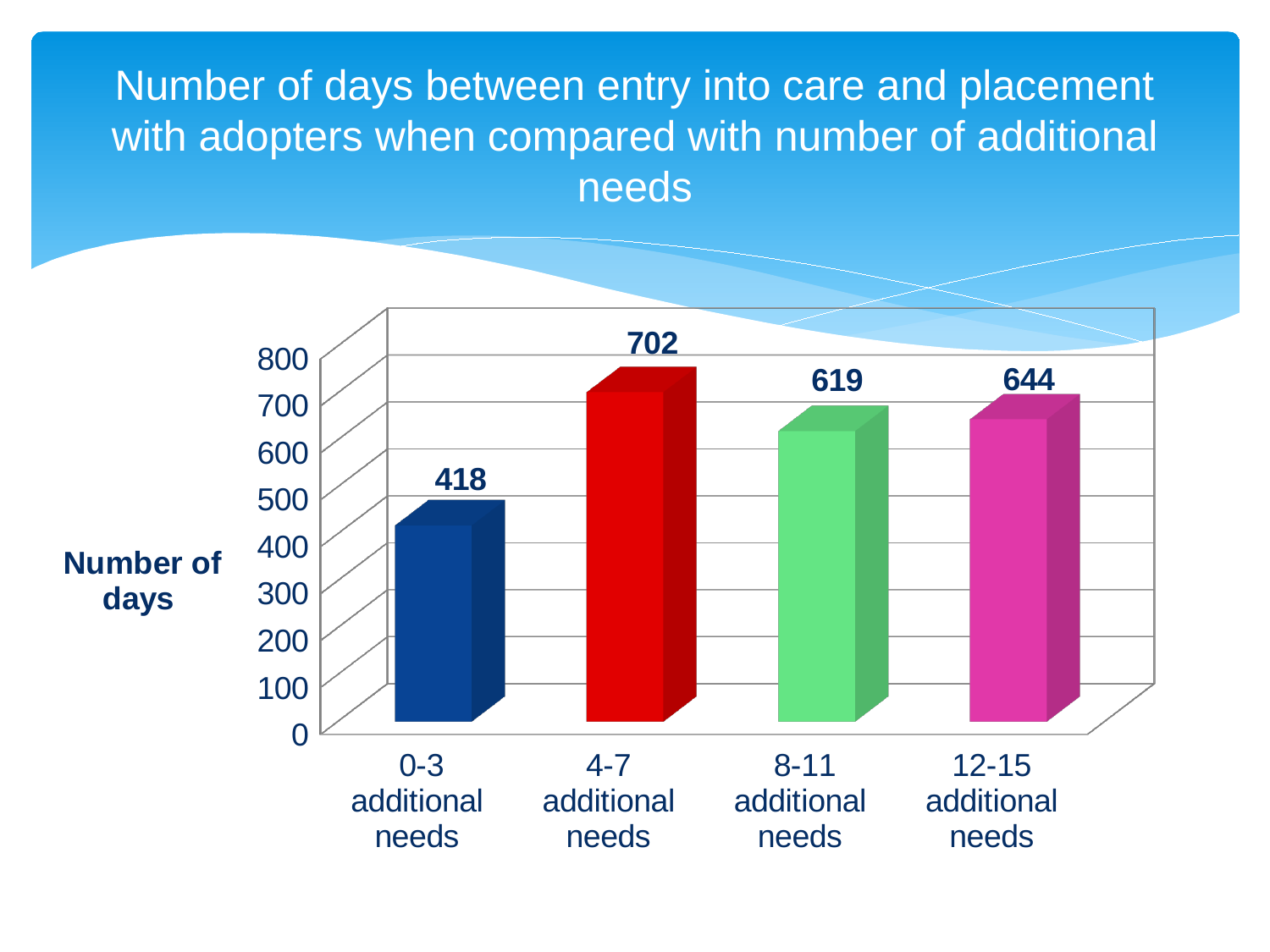
What is the number of days for the 12-15 additional needs category? 644 What is the label on the vertical axis of the chart? Number of days What is the number of days for the 4-7 additional needs category? 702 Which category has the lowest number of days? 0-3 additional needs What kind of chart is shown on the slide? Bar chart What is the number of days for the 0-3 additional needs category? 418 Which has a larger number of days: 8-11 additional needs or 12-15 additional needs? 12-15 additional needs What is the difference in number of days between the 12-15 additional needs and 8-11 additional needs categories? 25 What is the difference in number of days between the 4-7 additional needs and 0-3 additional needs categories? 284 What is the number of days for the 8-11 additional needs category? 619 How many categories are shown on the chart? 4 Which category has the highest number of days? 4-7 additional needs